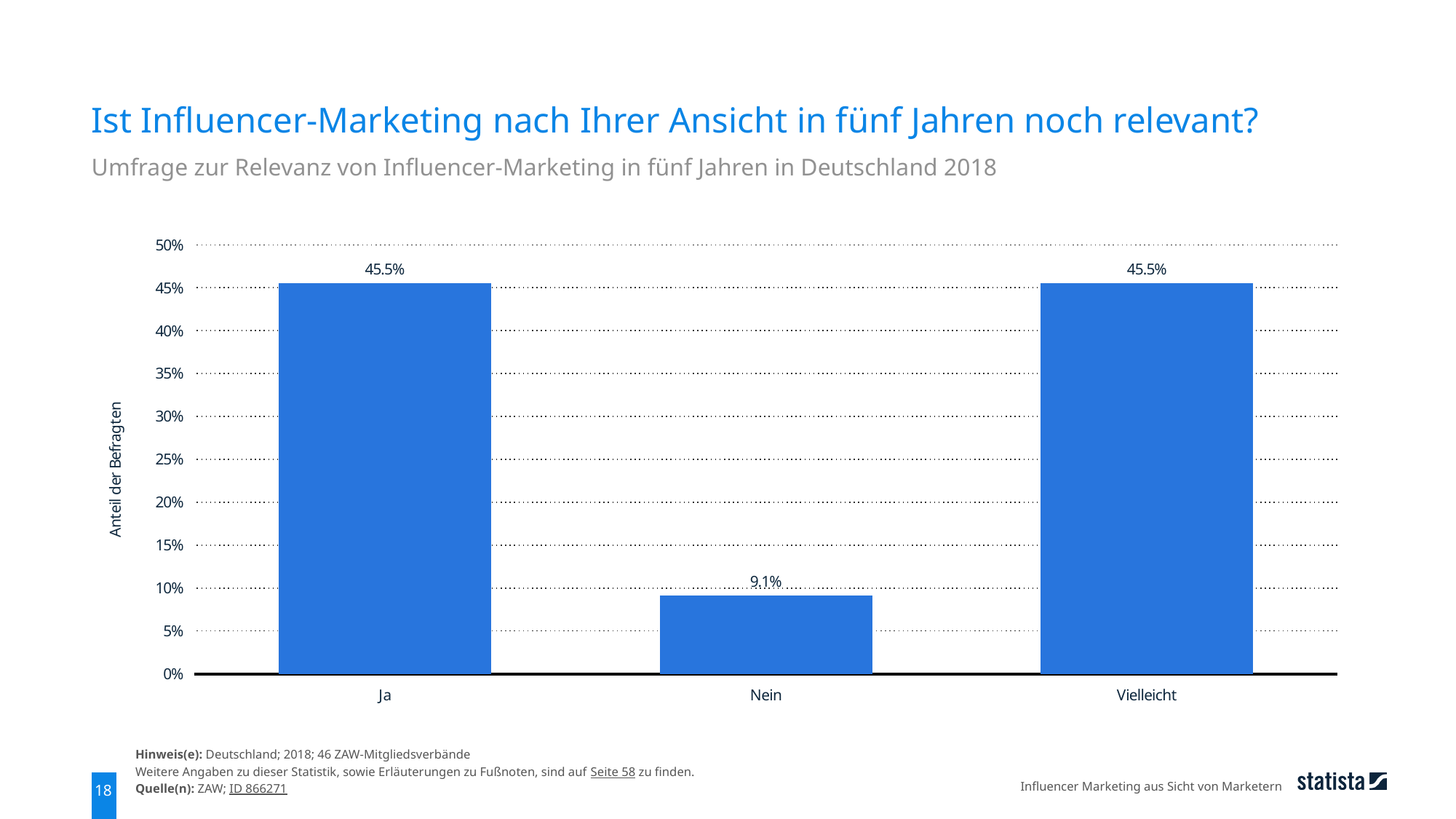
What is the label of the y axis? Anteil der Befragten Which is larger, the value for "Nein" or the value for "Vielleicht"? Vielleicht What is the title of the chart? Ist Influencer-Marketing nach Ihrer Ansicht in fünf Jahren noch relevant? Is the value for "Nein" greater or less than 10%? less What is the value for "Nein"? 9.1% What is the value for "Ja"? 45.5% What kind of chart is shown on the slide? bar chart What is the difference between the values for "Ja" and "Nein"? 36.4% Which category has the lowest value? Nein What is the value for "Vielleicht"? 45.5% Is the value for "Ja" greater or less than 40%? greater How many categories are shown on the x axis? 3